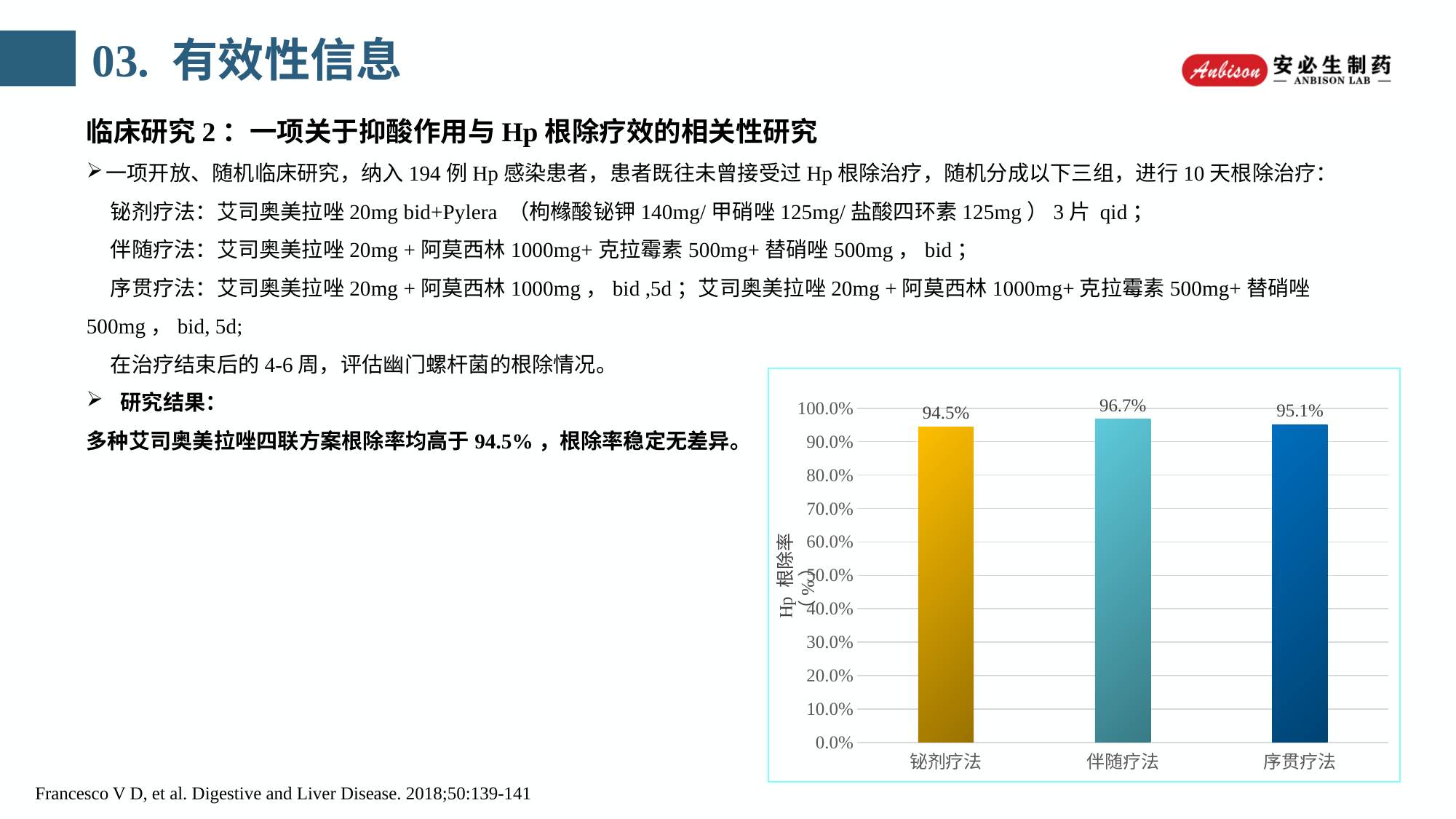
What is the label on the vertical axis of the chart? Hp 根除率（%） Is the value for 铋剂疗法 greater or less than 90.0%? greater Which treatment group has the lowest eradication rate in the chart? 铋剂疗法 Which treatment group has the highest eradication rate in the chart? 伴随疗法 What is the Hp eradication rate shown for 伴随疗法? 96.7% What is the difference in eradication rate between 伴随疗法 and 铋剂疗法? 2.2 percentage points What is the Hp eradication rate shown for 铋剂疗法? 94.5% What is the difference in eradication rate between 序贯疗法 and 铋剂疗法? 0.6 percentage points What is the Hp eradication rate shown for 序贯疗法? 95.1% What kind of chart is shown on the slide? Bar chart How many treatment groups are plotted in the chart? 3 Which has a higher eradication rate, 序贯疗法 or 铋剂疗法? 序贯疗法